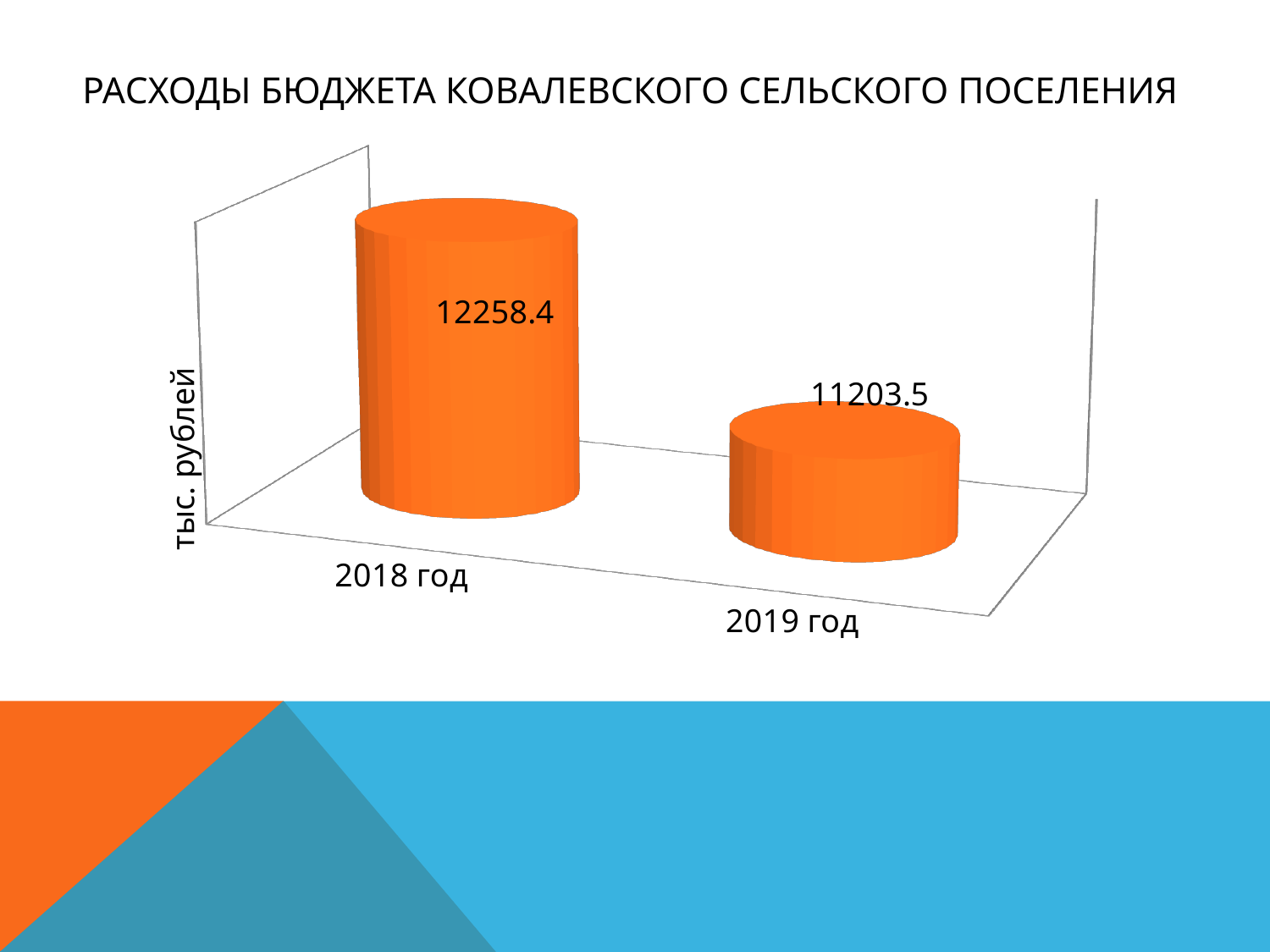
Which year has the lowest value? 2019 год Do the values rise or fall from 2018 год to 2019 год? fall How many categories are shown on the chart? 2 Which year has the highest value? 2018 год What kind of chart is shown on the slide? bar chart What is the value for 2018 год? 12258.4 What is the difference between the values for 2018 год and 2019 год? 1054.9 What is the label on the vertical axis? тыс. рублей What is the title of the chart? РАСХОДЫ БЮДЖЕТА КОВАЛЕВСКОГО СЕЛЬСКОГО ПОСЕЛЕНИЯ Which is larger, the value for 2018 год or for 2019 год? 2018 год What is the value for 2019 год? 11203.5